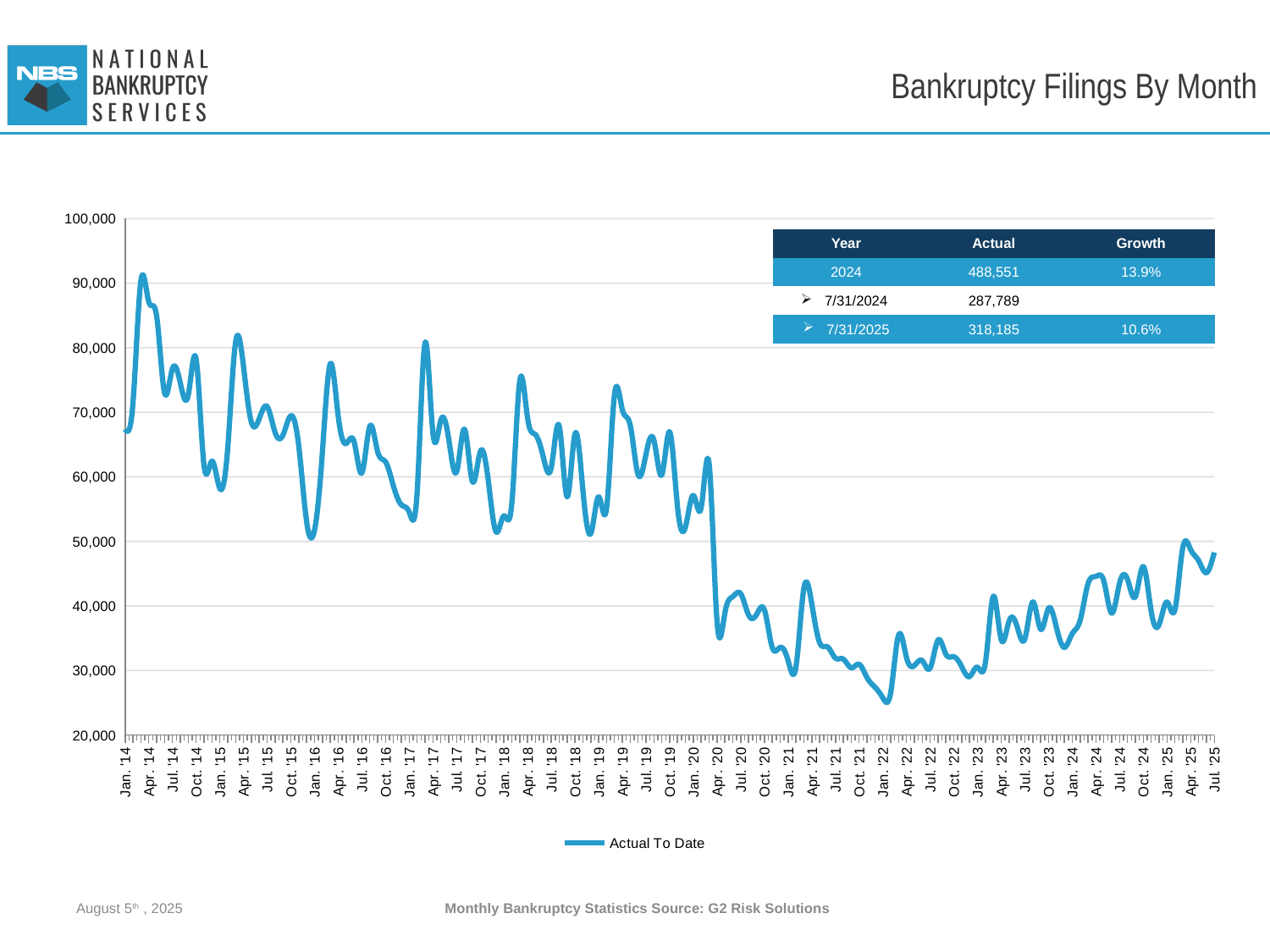
Overall, do bankruptcy filings rise or fall from Jan. '14 to Jul. '25? fall What is the title of the chart? Bankruptcy Filings By Month What kind of chart is shown on the slide? line chart According to the table on the chart, what is the Actual value for 2024? 488,551 Which is larger, the value for Jan. '14 or the value for Jan. '22? Jan. '14 How many series does the chart legend list? 1 Is the value for Jan. '22 greater or less than 30,000? less Is the value for Jan. '14 greater or less than 60,000? greater What is the name of the series shown in the chart legend? Actual To Date Is the value for Jul. '25 greater or less than 50,000? less According to the table on the chart, what is the Growth shown for 7/31/2025? 10.6% According to the table on the chart, what is the Actual value for 7/31/2024? 287,789